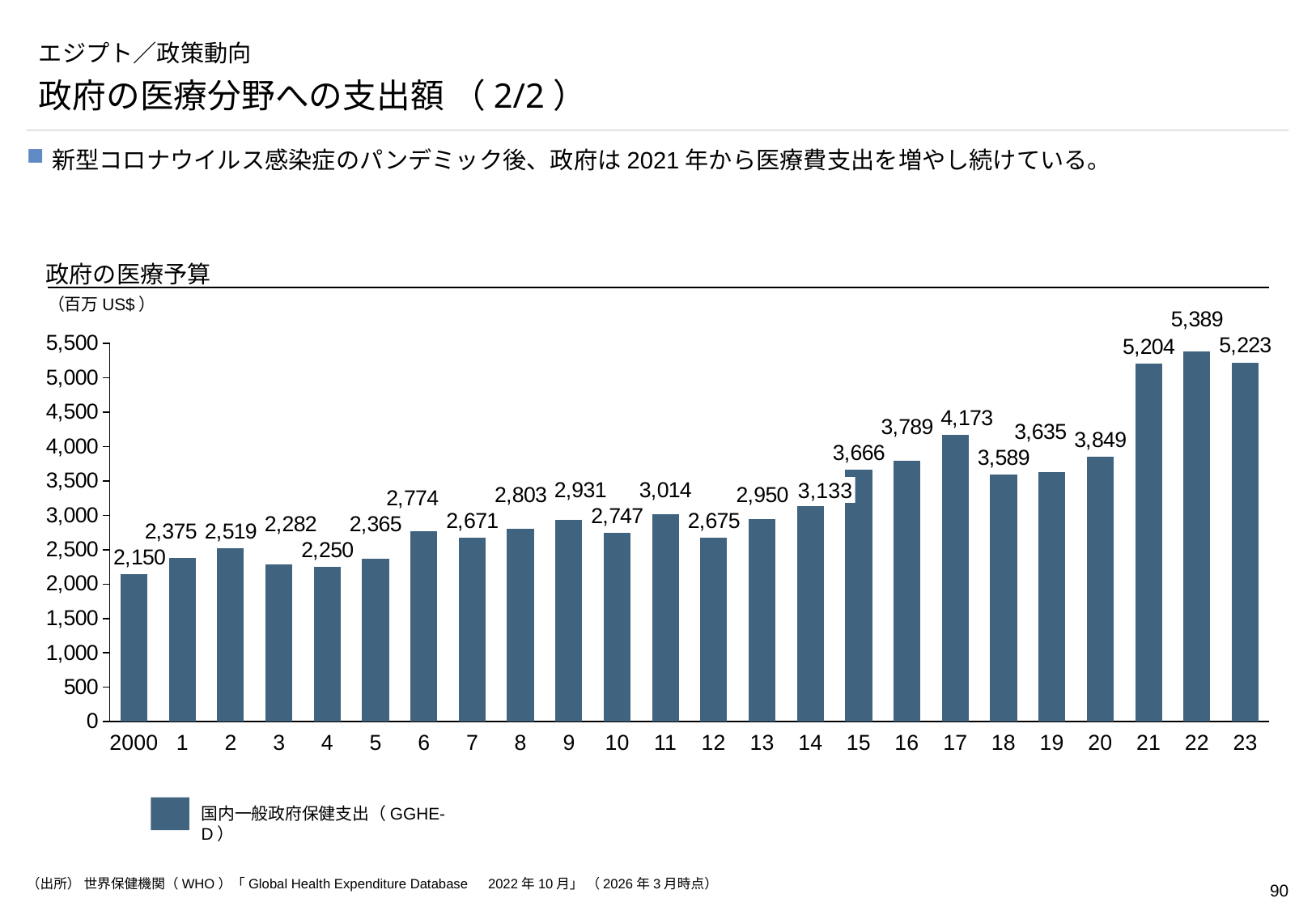
What is the value for 2000 in the 政府の医療予算 chart? 2,150 How many series does the legend of the 政府の医療予算 chart list? 1 What kind of chart is the 政府の医療予算 chart? bar chart Is the value for 14 greater or less than 3,000 in the 政府の医療予算 chart? greater What is the value for 22 in the 政府の医療予算 chart? 5,389 What is the difference between the values for 17 and 16 in the 政府の医療予算 chart? 384 What is the value for 17 in the 政府の医療予算 chart? 4,173 Which is larger in the 政府の医療予算 chart, the value for 18 or the value for 20? 20 What is the difference between the values for 22 and 21 in the 政府の医療予算 chart? 185 Which year has the highest value in the 政府の医療予算 chart? 22 Which year has the lowest value in the 政府の医療予算 chart? 2000 How many bars are plotted in the 政府の医療予算 chart? 24